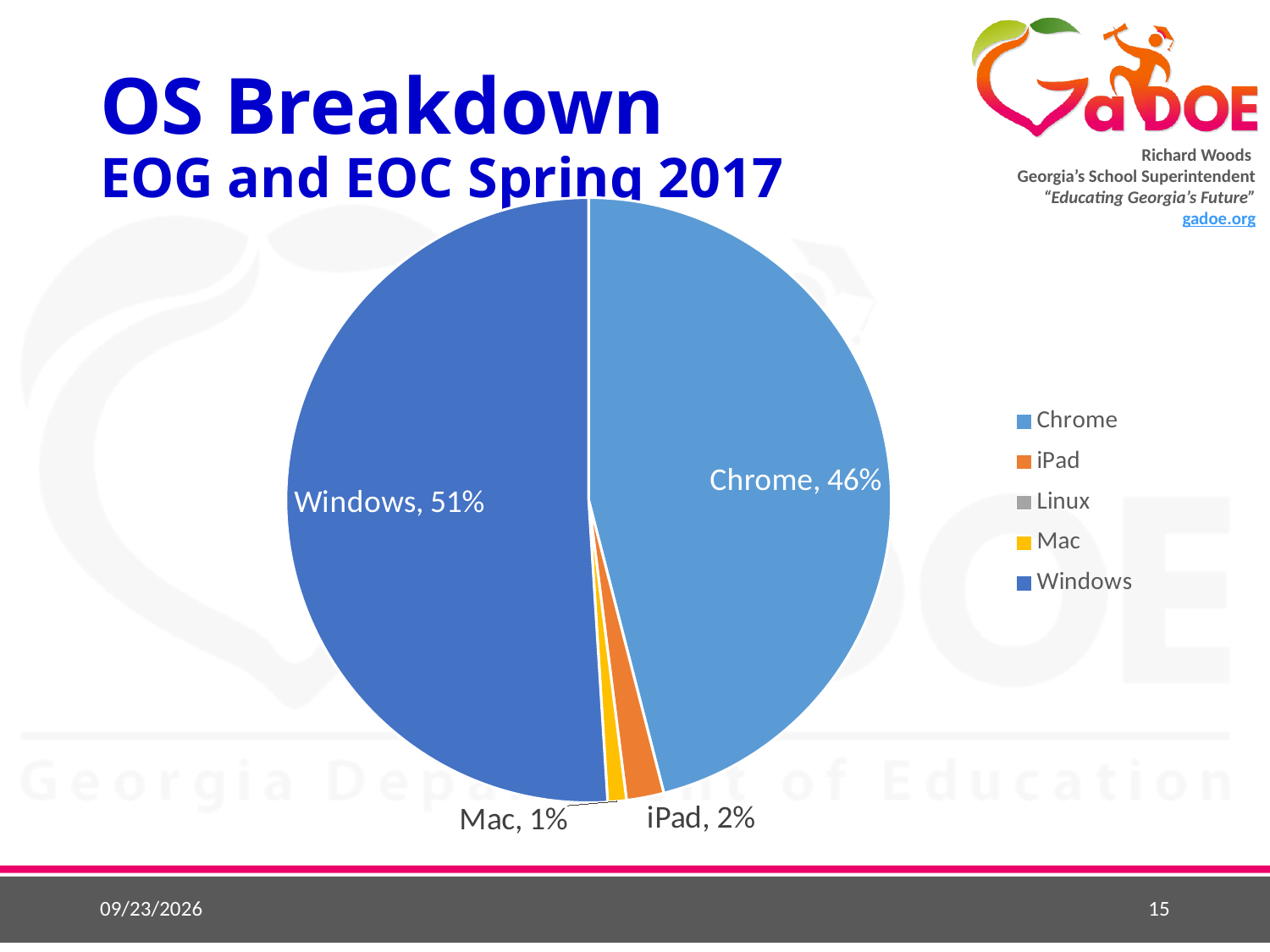
What is the difference in percentage points between the Windows and Chrome shares? 5 What share of the pie does Mac have? 1% What colour is the Windows slice in the pie chart? Blue Which of Windows or Chrome has the larger share? Windows What kind of chart is shown on the slide? Pie chart What share of the pie does iPad have? 2% Which operating system has the largest share of the pie? Windows Which of iPad or Mac has the larger share? iPad How many entries does the legend list? 5 What share of the pie does Chrome have? 46% What is the difference in percentage points between the iPad and Mac shares? 1 What share of the pie does Windows have? 51%